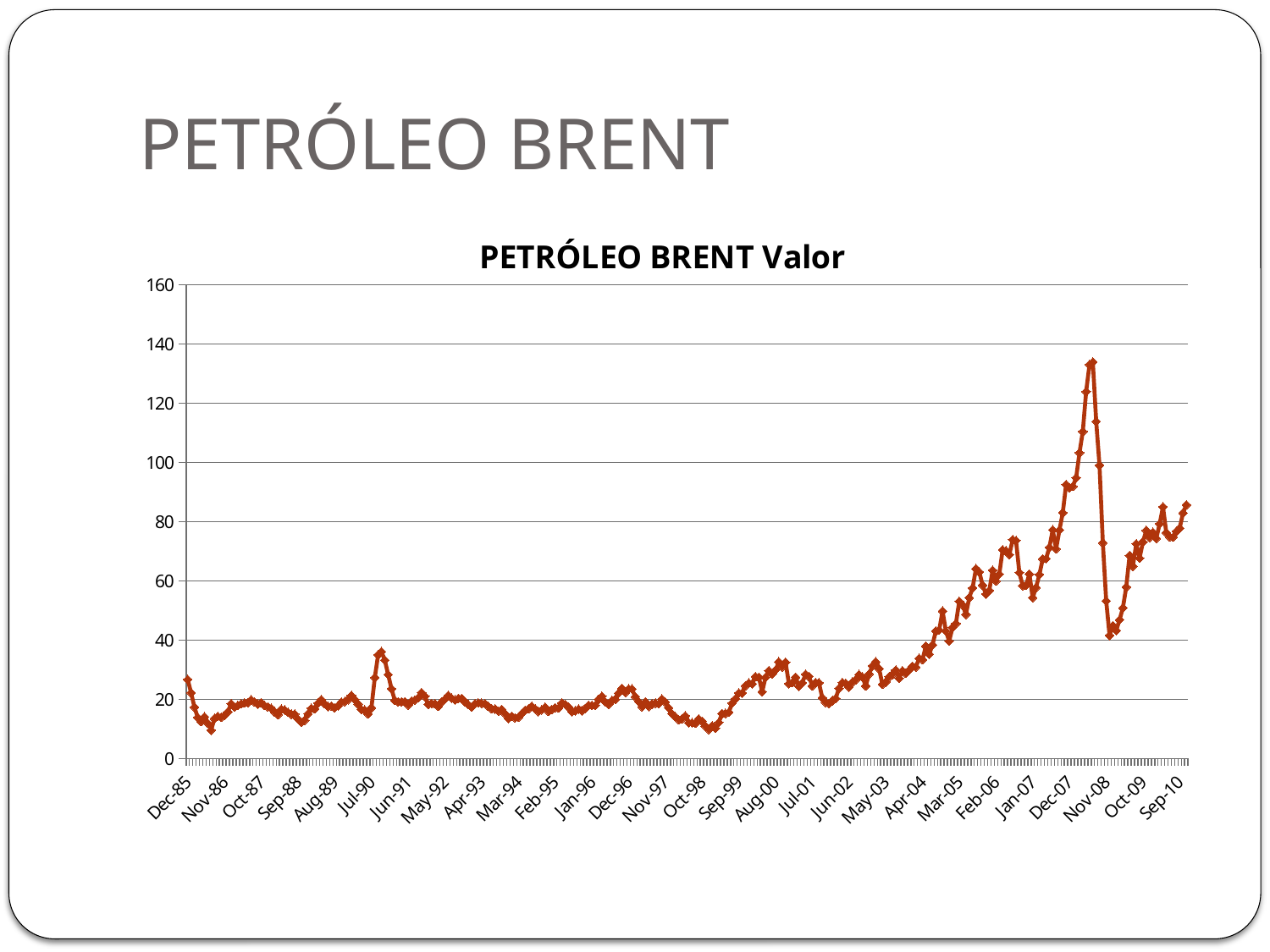
What is the highest value shown on the vertical axis? 160 What kind of chart is shown on the slide? Line chart How many date labels are shown along the x axis? 28 Is the value at Sep-10 greater or less than 60? greater Which is larger, the value at Dec-85 or the value at Sep-10? Sep-10 Overall, do the values rise or fall from Dec-85 to Sep-10? Rise How many data series are plotted on the chart? 1 Is the value at Dec-85 greater or less than 40? less Is the peak value of the line greater or less than 120? greater What is the title of the chart? PETRÓLEO BRENT Valor